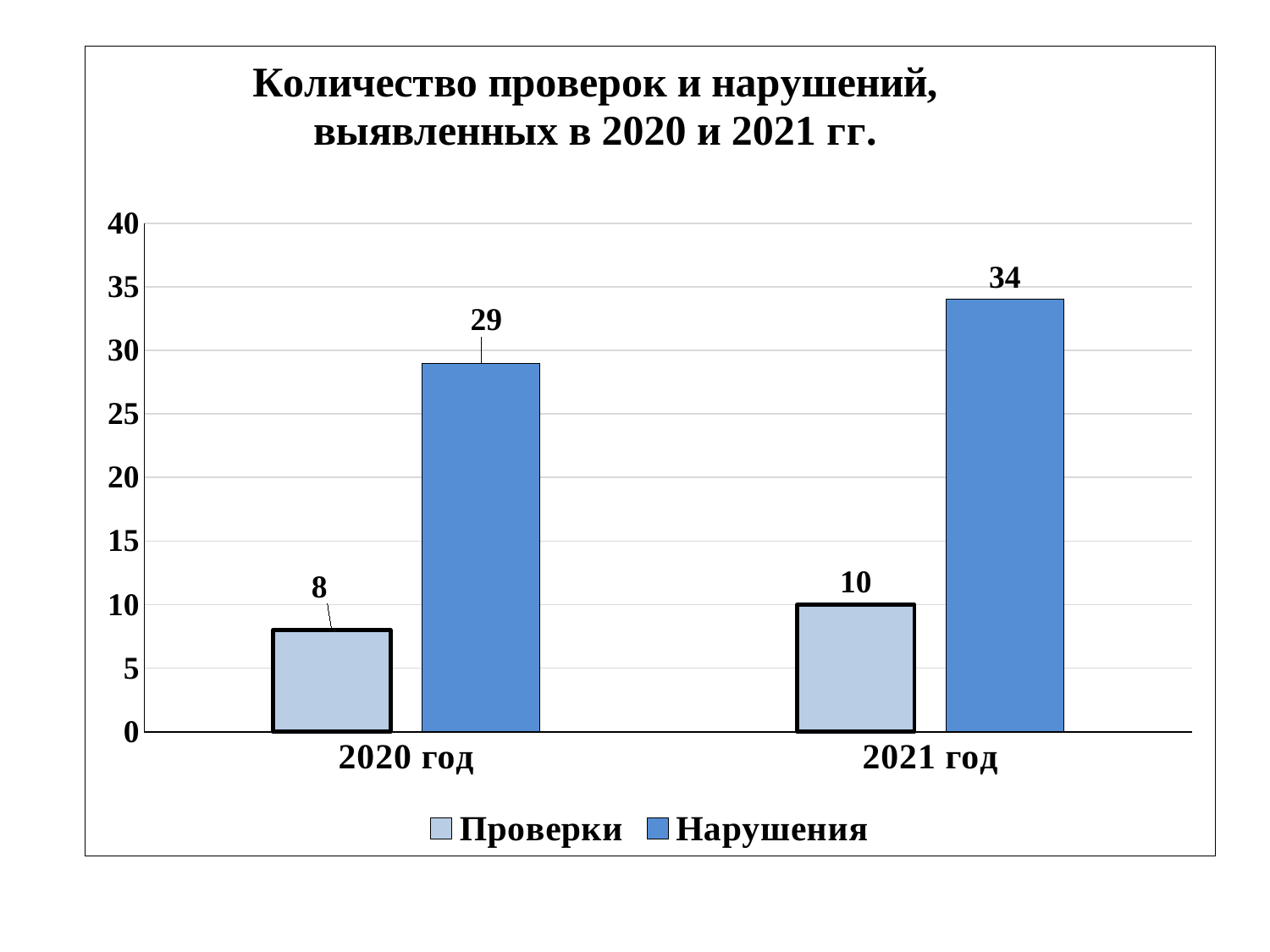
How many series does the legend list? 2 What is the value of Проверки for 2020 год? 8 What is the value of Нарушения for 2021 год? 34 Which is larger in 2020 год: Проверки or Нарушения? Нарушения What is the value of Проверки for 2021 год? 10 What is the value of Нарушения for 2020 год? 29 What is the difference between Нарушения in 2021 год and 2020 год? 5 What kind of chart is shown on the slide? Bar chart Which year has the highest value for Нарушения? 2021 год How many categories are shown on the x axis? 2 Which year has the lowest value for Проверки? 2020 год Do the values for Проверки rise or fall from 2020 год to 2021 год? Rise